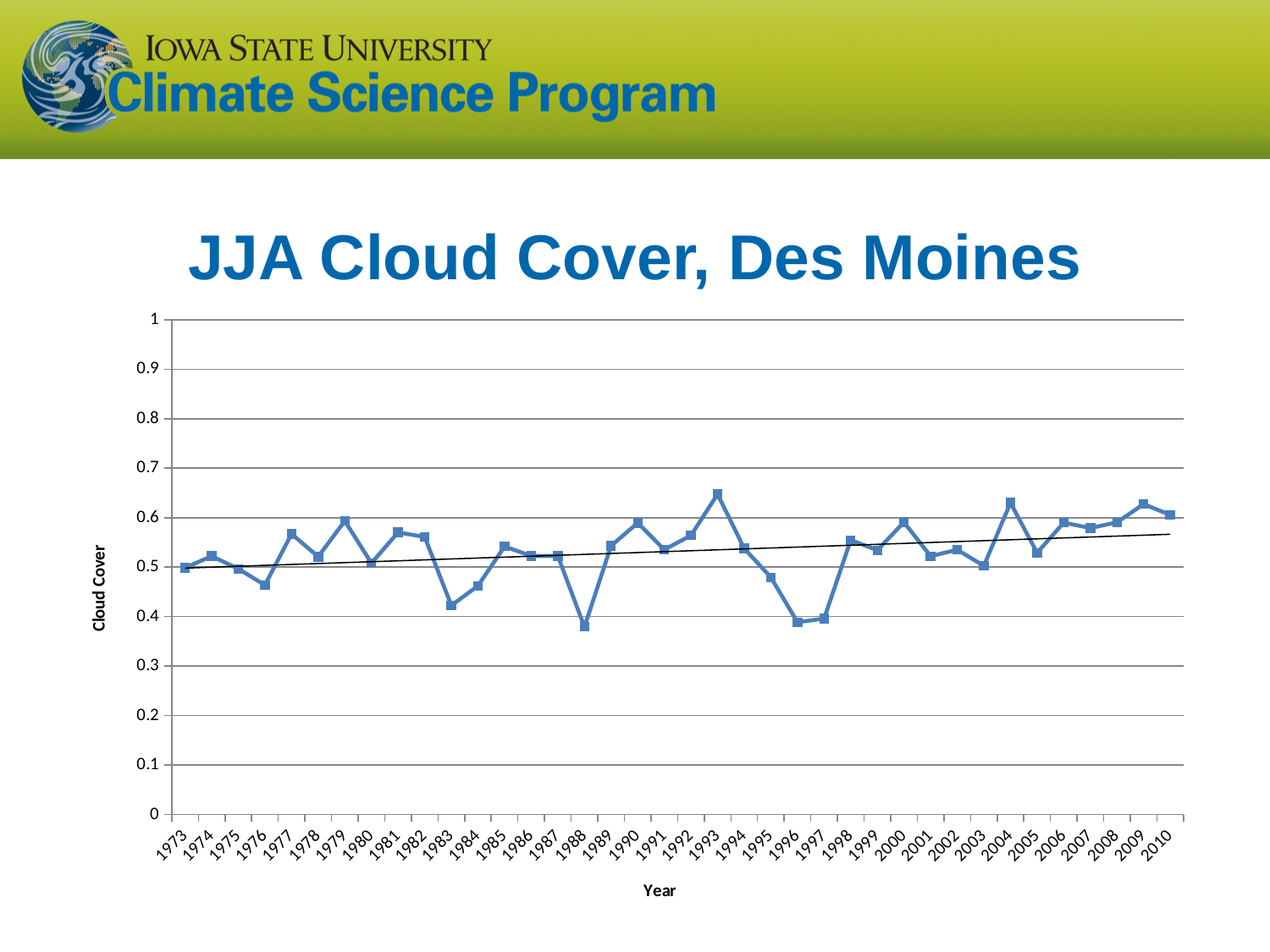
How many years are plotted along the x axis of the chart? 38 What kind of chart is shown on the slide? line chart Which year has the higher cloud cover value, 2004 or 1997? 2004 Which year has the higher cloud cover value, 1982 or 1983? 1982 What is the title of the chart? JJA Cloud Cover, Des Moines Which year has the higher cloud cover value, 1993 or 1988? 1993 Is the cloud cover value for 1993 greater or less than 0.6? greater Is the cloud cover value for 1996 greater or less than 0.5? less What is the label on the vertical axis of the chart? Cloud Cover Is the cloud cover value for 1983 greater or less than 0.5? less According to the trend line, does cloud cover rise or fall from 1973 to 2010? rise